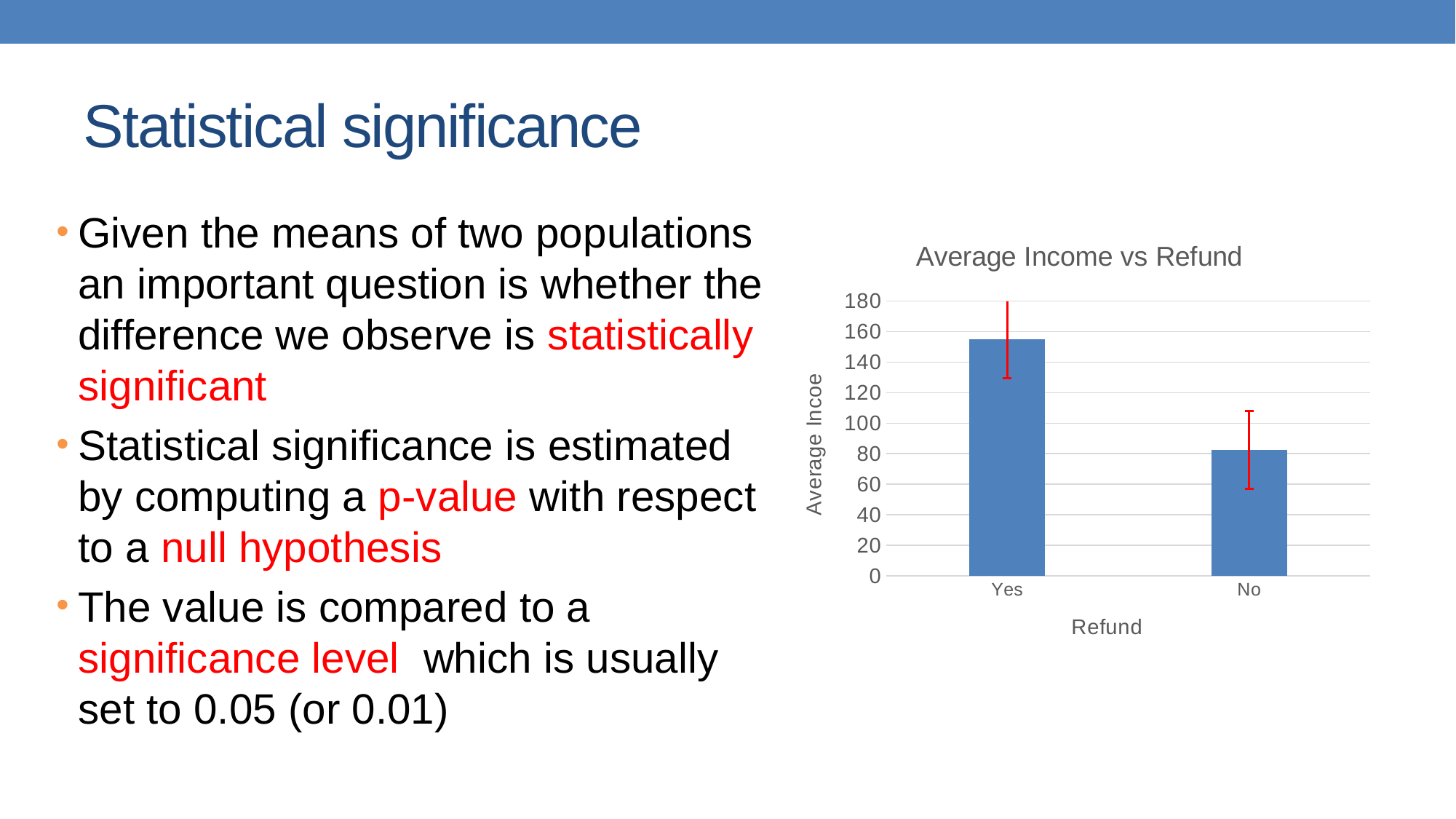
What kind of chart is shown on the slide? bar chart Is the average income for Yes greater or less than 160? less What is the title of the chart? Average Income vs Refund Do the bar values rise or fall from Yes to No along the x axis? fall What is the label of the x axis? Refund Is the average income for Yes greater or less than 140? greater Is the average income for No greater or less than 60? greater Which category has the highest average income? Yes Which is larger, the average income for Yes or for No? Yes How many categories are shown on the x axis of the chart? 2 Which category has the lowest average income? No